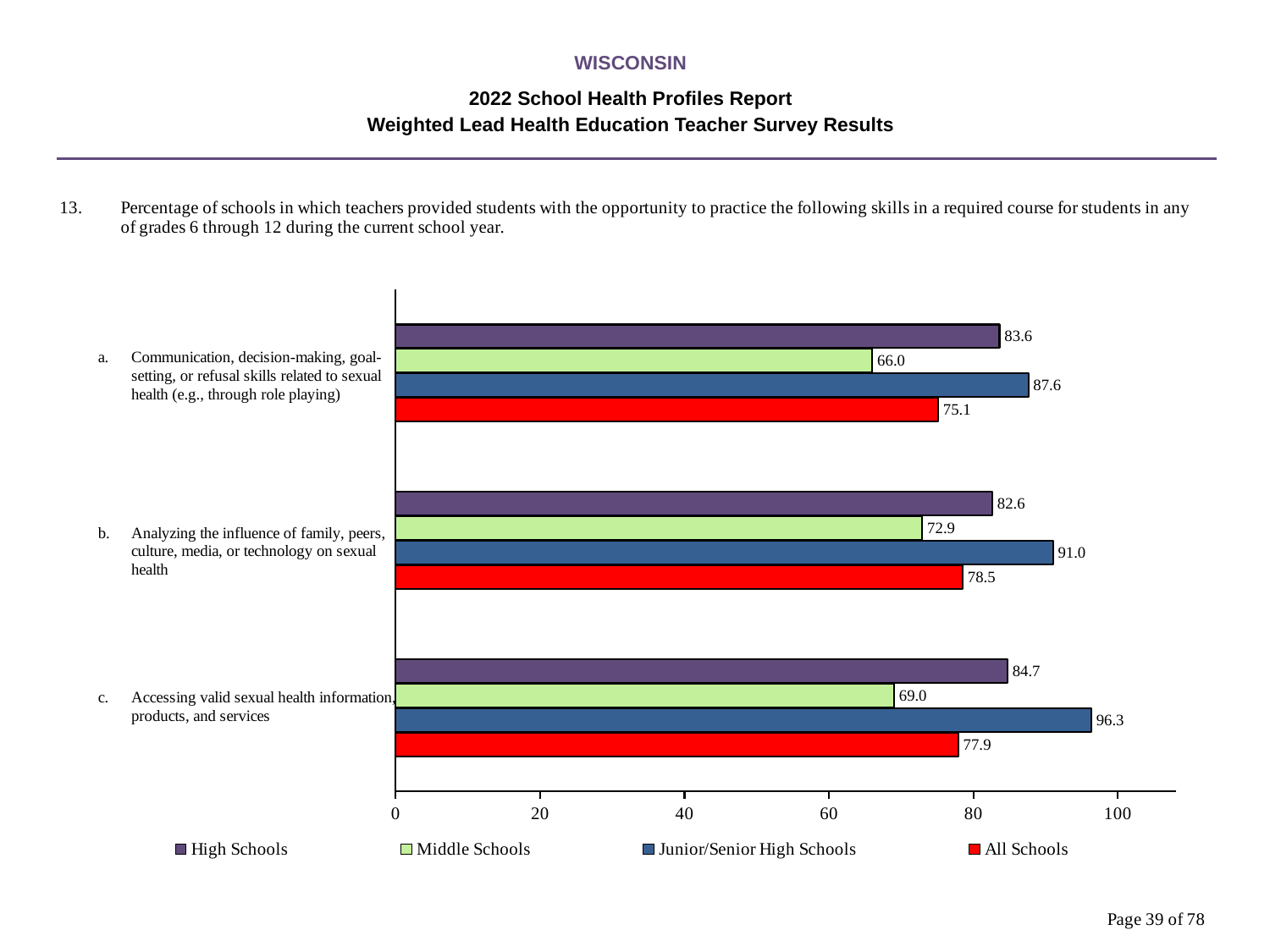
What is the All Schools value for item b, analyzing the influence of family, peers, culture, media, or technology on sexual health? 78.5 Which is larger: the High Schools value for item a or the High Schools value for item c? Item c (84.7) What is the difference between the Junior/Senior High Schools and Middle Schools values for item a, communication, decision-making, goal-setting, or refusal skills related to sexual health? 21.6 Which school type has the highest value for item b, analyzing the influence of family, peers, culture, media, or technology on sexual health? Junior/Senior High Schools What is the value for Junior/Senior High Schools for item c, accessing valid sexual health information, products, and services? 96.3 What is the value for Middle Schools for item a, communication, decision-making, goal-setting, or refusal skills related to sexual health? 66.0 What kind of chart is shown on the slide? Bar chart Which school type has the lowest value for item c, accessing valid sexual health information, products, and services? Middle Schools Which colour represents All Schools in the legend? Red How many skill categories are shown on the chart? 3 Is the Middle Schools value for item b, analyzing the influence of family, peers, culture, media, or technology on sexual health, greater or less than 80? less How many series does the legend list? 4